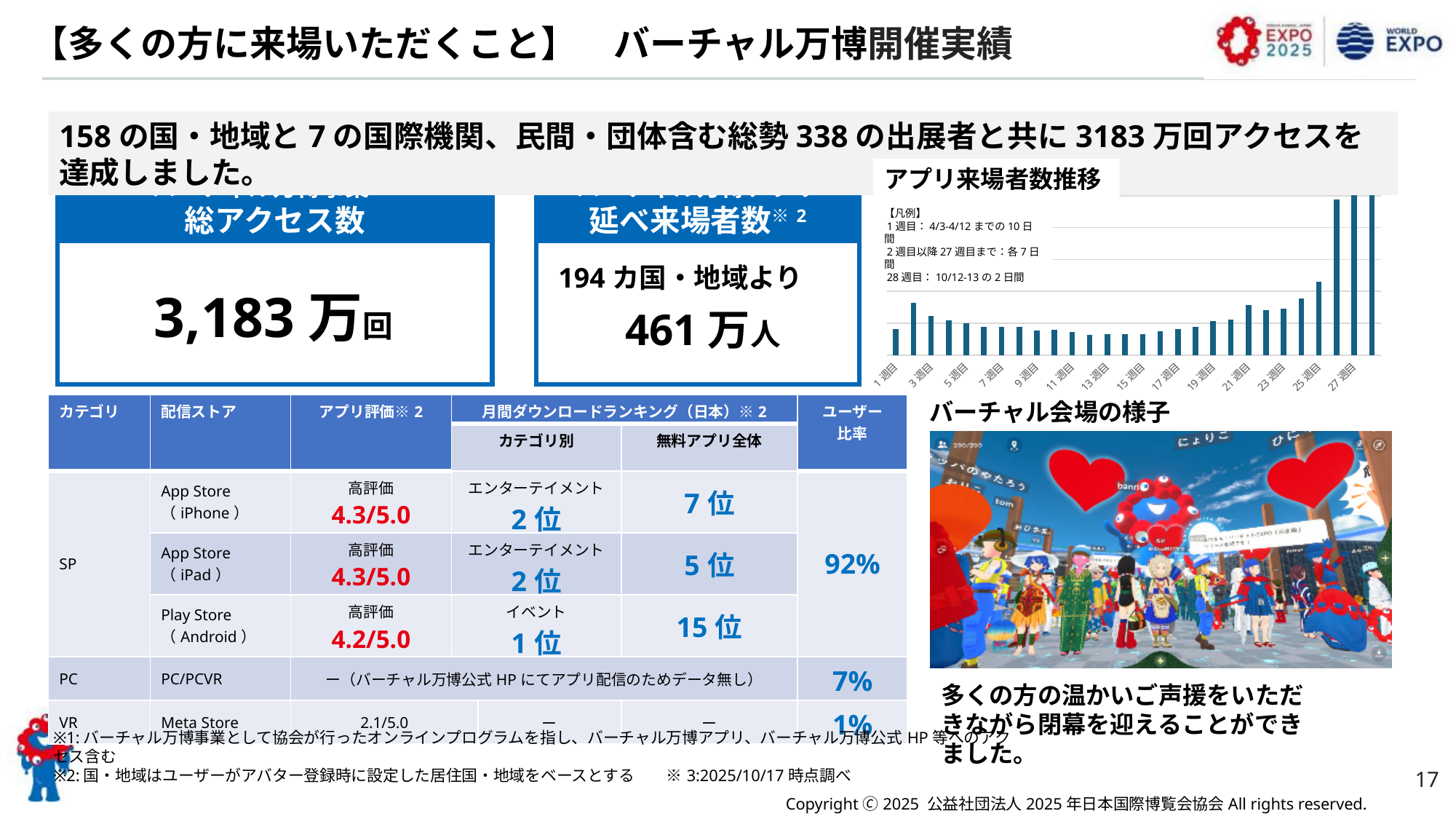
In the アプリ来場者数推移 chart, do the values rise or fall from 19週目 to 27週目? rise In the アプリ来場者数推移 chart, which is larger, the value for 11週目 or 27週目? 27週目 According to the legend note on the アプリ来場者数推移 chart, what date range does 1週目 cover? 4/3-4/12 What is the title of the bar chart on the right side of the slide? アプリ来場者数推移 In the アプリ来場者数推移 chart, which is larger, the value for 3週目 or 25週目? 25週目 What kind of chart is the アプリ来場者数推移 chart? bar chart How many week labels are printed along the x axis of the アプリ来場者数推移 chart? 14 In the アプリ来場者数推移 chart, which is larger, the value for 1週目 or 2週目? 2週目 In the アプリ来場者数推移 chart, do the values rise or fall from 2週目 to 9週目? fall